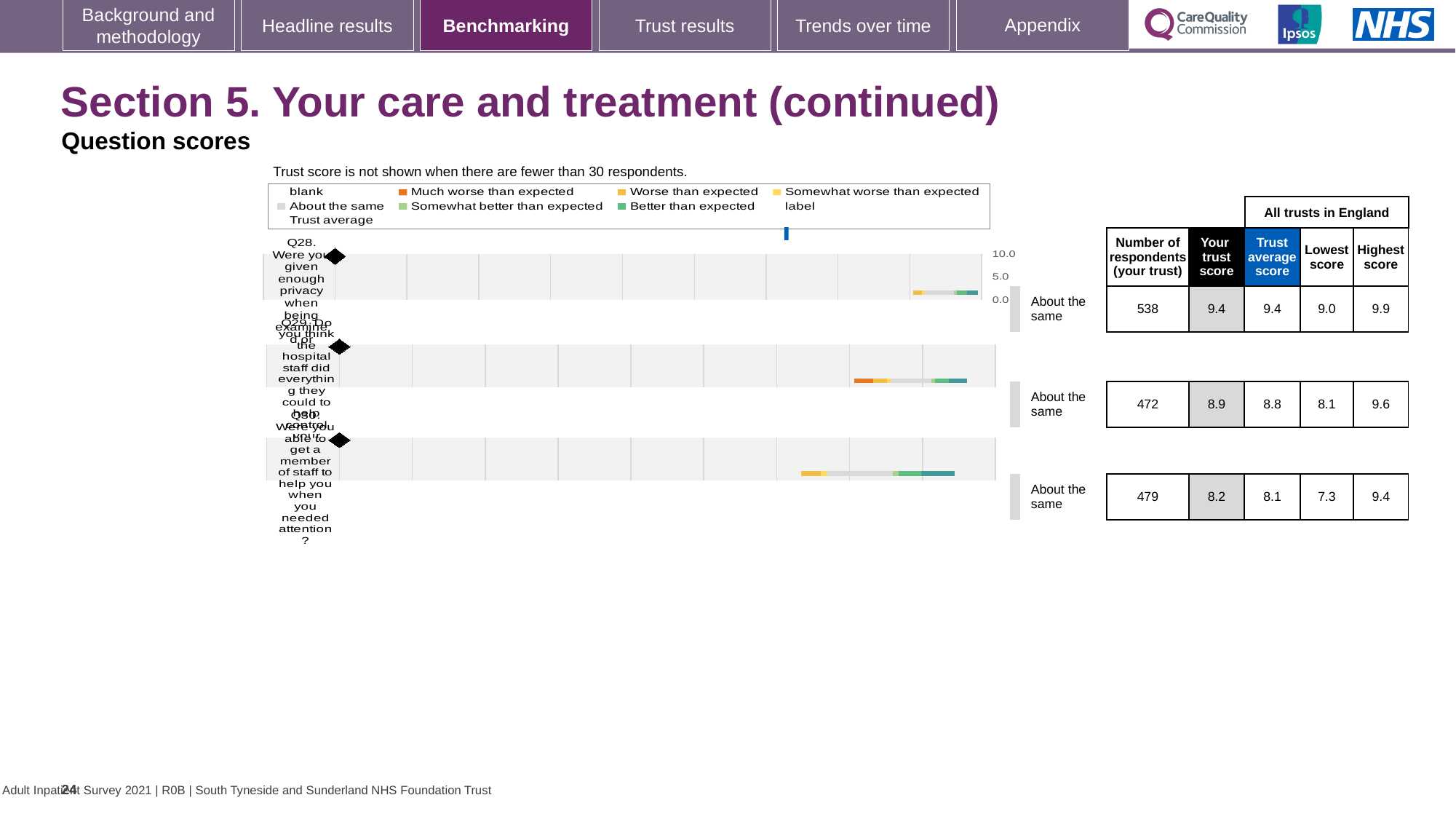
Is the trust score for Q30 greater or less than 5.0? greater Which question has the highest trust score? Q28 What is the trust score for Q30 (Were you able to get a member of staff to help you when you needed attention)? 8.2 What is the trust score for Q28 (Were you given enough privacy when being examined or treated)? 9.4 What is the trust score for Q29 (Do you think the hospital staff did everything they could to help control your pain)? 8.9 How many questions (Q28, Q29, Q30) are plotted in the question scores chart? 3 What benchmark category is shown for Q28? About the same What kind of chart is used to show the question scores on this slide? bar chart For Q29, which is larger: the trust score or the trust average score? the trust score (8.9) What is the difference between the trust scores for Q28 and Q30? 1.2 Which question has the lowest trust score? Q30 How many respondents answered Q28 at this trust? 538